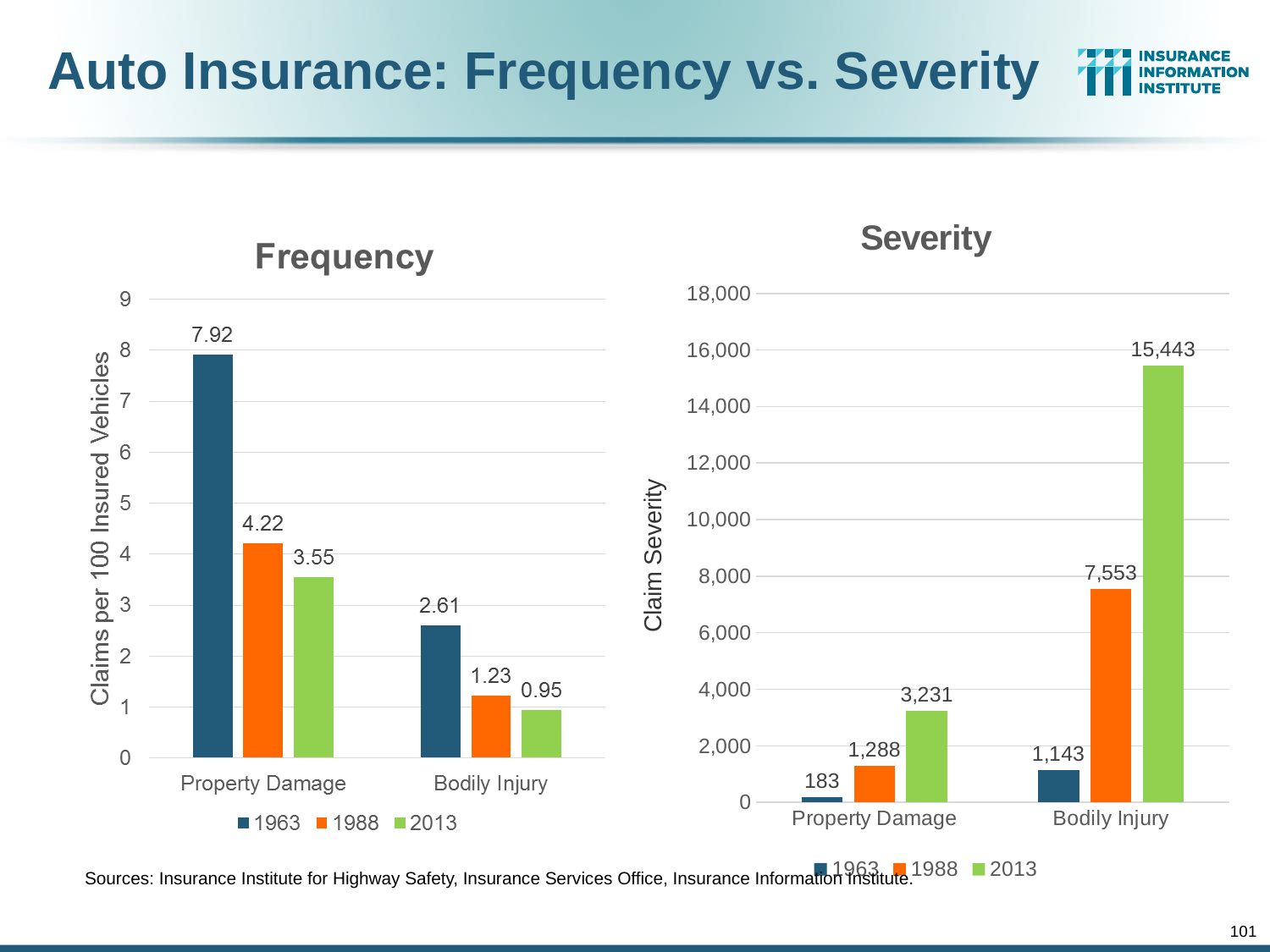
In the Frequency chart, what is the value for Bodily Injury in 2013? 0.95 In the Frequency chart, what is the difference between the 1963 and 1988 values for Property Damage? 3.70 In the Severity chart, which bar is the highest? Bodily Injury, 2013 How many series does the legend of the Frequency chart list? 3 In the Severity chart, which is larger: Property Damage in 2013 or Bodily Injury in 1988? Bodily Injury in 1988 In the Severity chart, what is the claim severity for Bodily Injury in 2013? 15,443 What kind of chart is the Severity chart? Bar chart In the Severity chart, what is the claim severity for Property Damage in 1963? 183 In the Frequency chart, which bar is the lowest? Bodily Injury, 2013 In the Severity chart, what is the difference between the 2013 and 1988 values for Bodily Injury? 7,890 In the Frequency chart, what is the value for Property Damage in 1963? 7.92 In the Frequency chart, do the Property Damage values rise or fall from 1963 to 2013? Fall